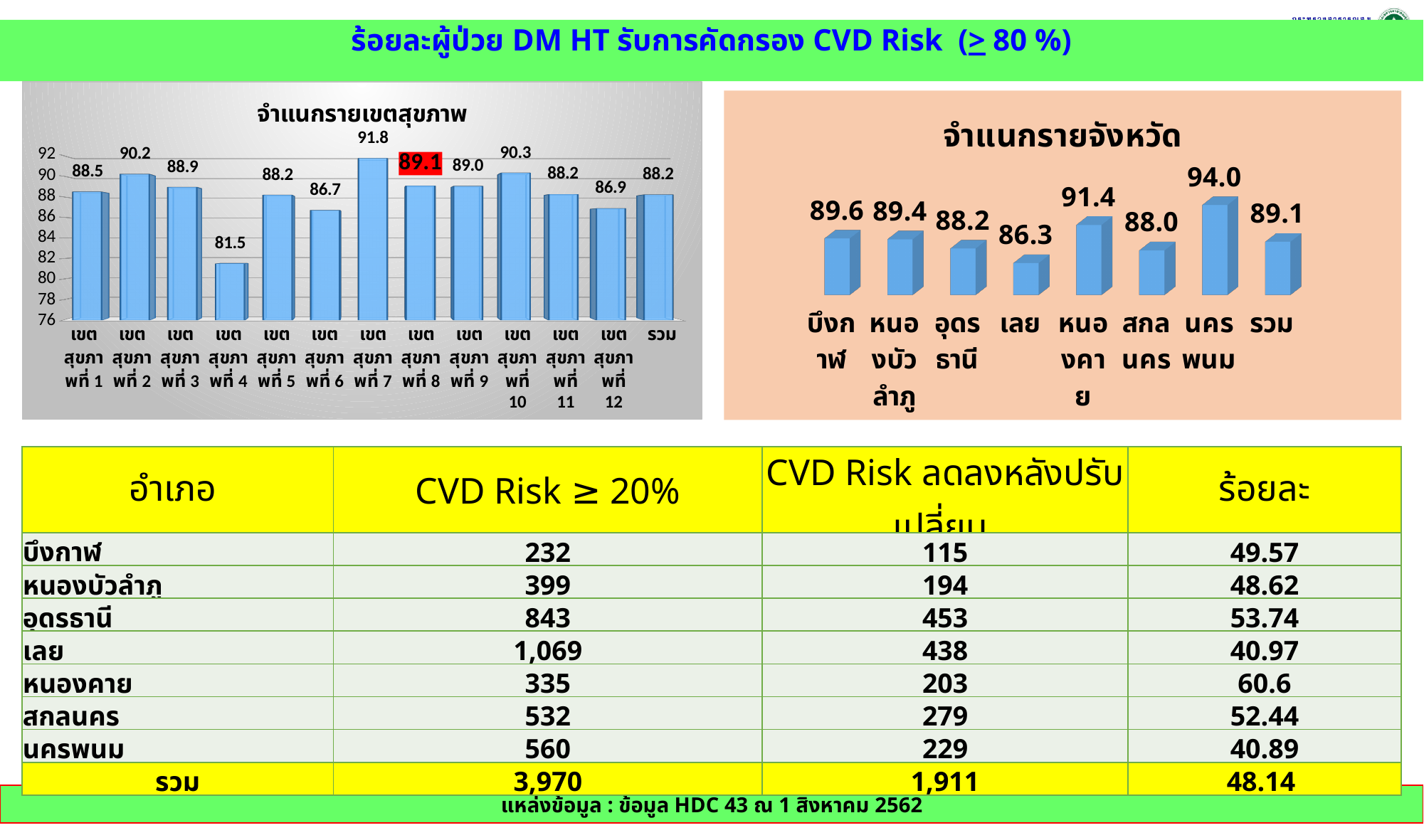
In the chart titled จำแนกรายจังหวัด, what is the value for เลย? 86.3 What type of chart is the chart titled จำแนกรายจังหวัด? Bar chart In the chart titled จำแนกรายจังหวัด, what is the value for รวม? 89.1 In the chart titled จำแนกรายเขตสุขภาพ, how many bars are plotted? 13 In the chart titled จำแนกรายจังหวัด, what is the difference between นครพนม and เลย? 7.7 In the chart titled จำแนกรายเขตสุขภาพ, which value is highlighted in red? 89.1 (เขตสุขภาพที่ 8) In the chart titled จำแนกรายเขตสุขภาพ, what is the value for เขตสุขภาพที่ 7? 91.8 In the chart titled จำแนกรายเขตสุขภาพ, what is the difference between เขตสุขภาพที่ 7 and เขตสุขภาพที่ 4? 10.3 In the chart titled จำแนกรายจังหวัด, which province has the highest value? นครพนม In the chart titled จำแนกรายเขตสุขภาพ, what is the value for รวม? 88.2 In the chart titled จำแนกรายจังหวัด, which is larger, หนองคาย or สกลนคร? หนองคาย In the chart titled จำแนกรายเขตสุขภาพ, which health region has the lowest value? เขตสุขภาพที่ 4